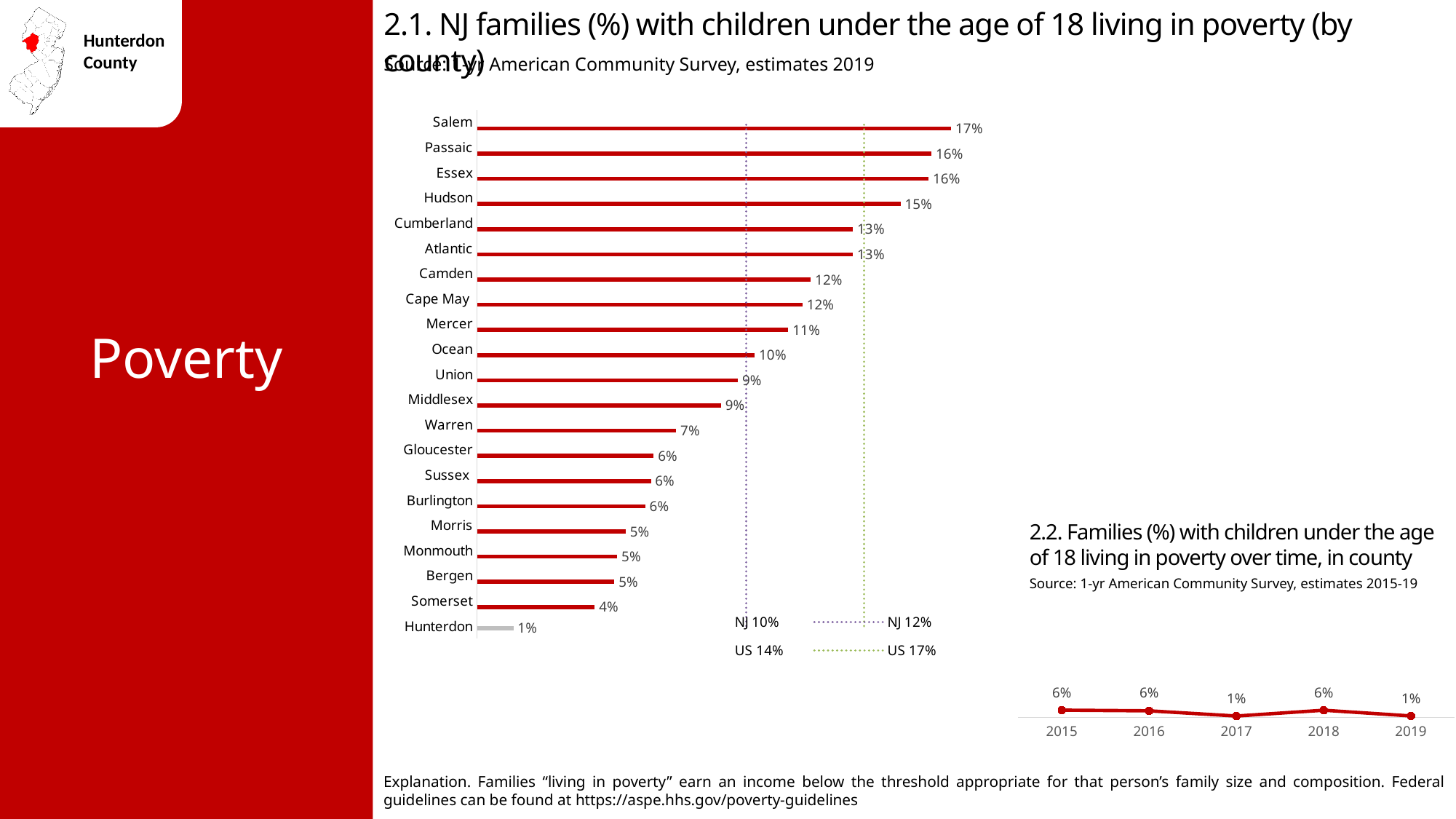
In chart 2.1 (by county), what is the value for Hudson? 15% In chart 2.1 (by county), what is the difference between Salem and Somerset? 13% In chart 2.2 (over time, in county), how many years are plotted? 5 What kind of chart is chart 2.1 (by county)? Bar chart In chart 2.1 (by county), which county has the highest percentage of families with children living in poverty? Salem In chart 2.1 (by county), which county has the lowest percentage? Hunterdon In chart 2.1 (by county), how many counties are shown? 21 In chart 2.1 (by county), which is larger, the value for Mercer or the value for Warren? Mercer What kind of chart is chart 2.2 (over time, in county)? Line chart In chart 2.1 (NJ families with children under 18 living in poverty by county), what is the value for Hunterdon? 1% In chart 2.2 (families in poverty over time, in county), what is the value for 2017? 1%